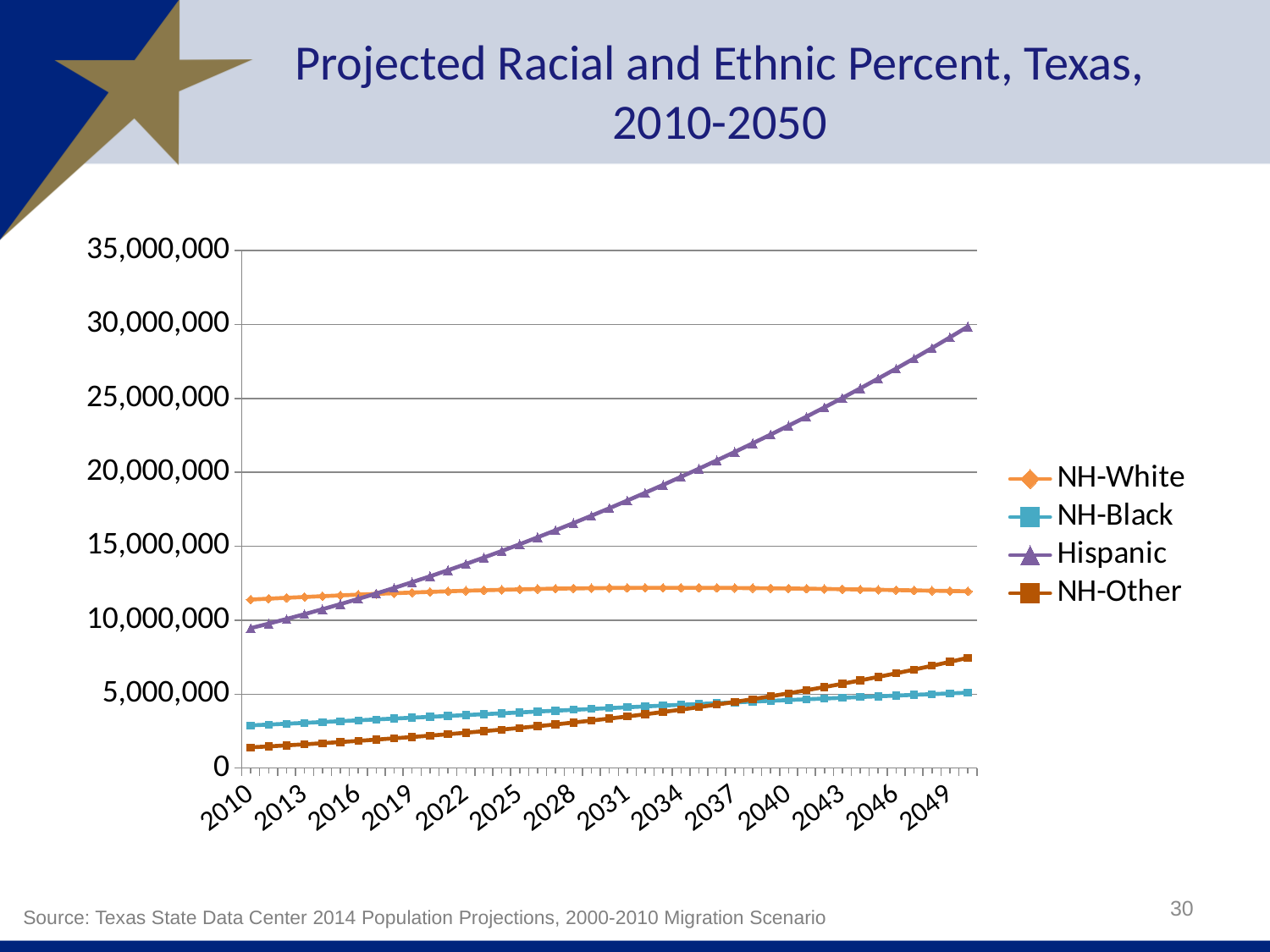
Is the value for Hispanic in 2050 greater or less than 25,000,000? greater Is the value for NH-White in 2010 greater or less than 10,000,000? greater Is the value for NH-Other in 2010 greater or less than 5,000,000? less What kind of chart is shown on the slide? line chart How many series does the legend list? 4 Does the Hispanic series rise or fall from 2010 to 2050? rise Which series has the lowest value in 2010? NH-Other Which series has the highest value in 2050? Hispanic In 2010, which is larger: NH-White or Hispanic? NH-White What is the title of the slide's chart? Projected Racial and Ethnic Percent, Texas, 2010-2050 In 2050, which is larger: NH-Other or NH-Black? NH-Other